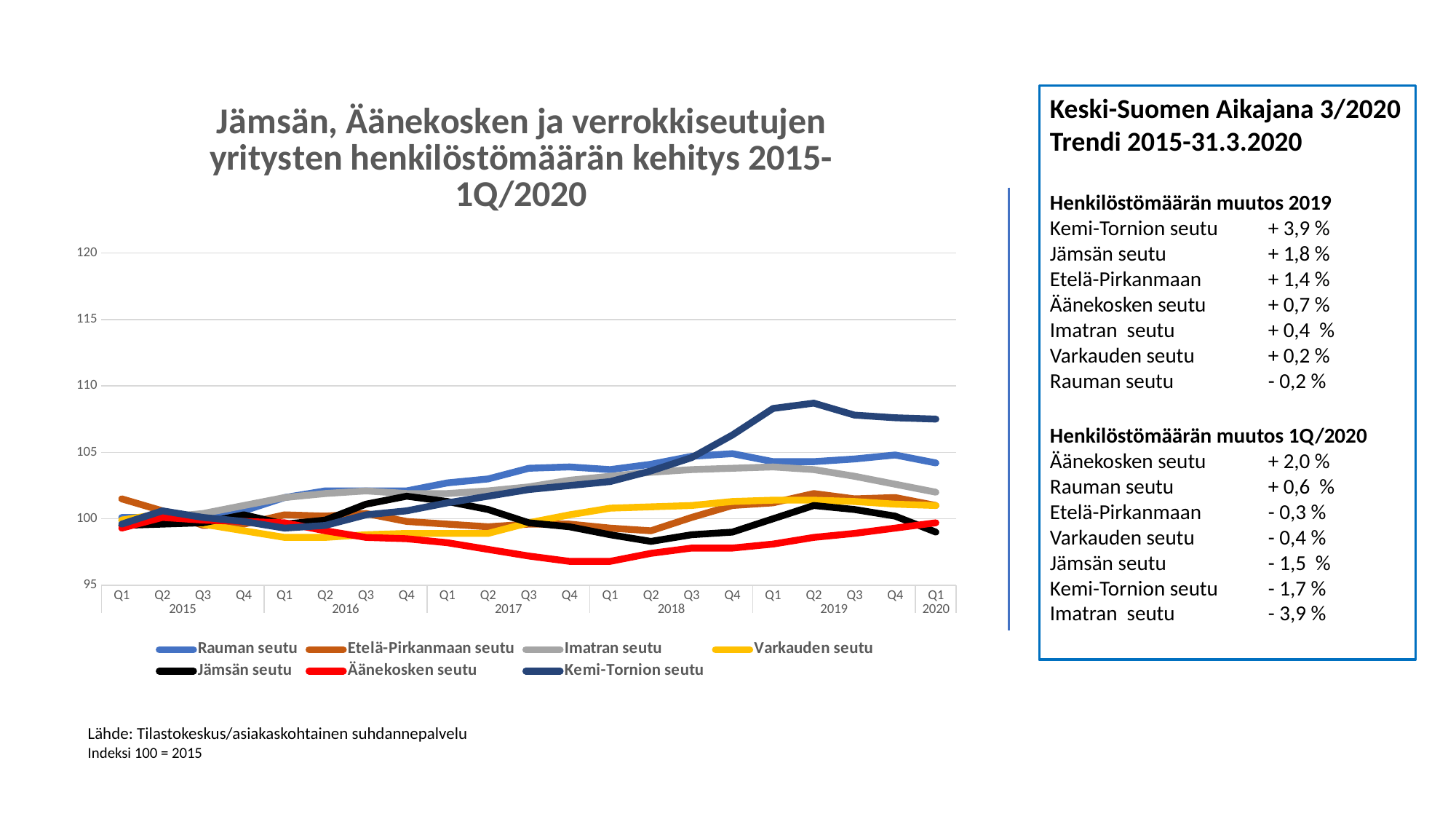
What colour is the Kemi-Tornion seutu line in the chart? dark blue Does the Äänekosken seutu line rise or fall from Q1 2015 to Q4 2017? fall How many series does the chart legend list? 7 Which series has the lowest value at Q4 2017? Äänekosken seutu Does the Kemi-Tornion seutu line rise or fall overall from Q1 2015 to Q1 2020? rise Is the value for Kemi-Tornion seutu at Q1 2020 greater or less than 110? less How many quarterly points are plotted along the x axis of the chart? 21 Is the value for Äänekosken seutu at Q4 2017 greater or less than 100? less Which is larger at Q1 2020, the value for Kemi-Tornion seutu or the value for Jämsän seutu? Kemi-Tornion seutu Which series has the highest value at Q1 2020? Kemi-Tornion seutu What kind of chart is shown on the slide? line chart Is the value for Kemi-Tornion seutu at Q2 2019 greater or less than 105? greater